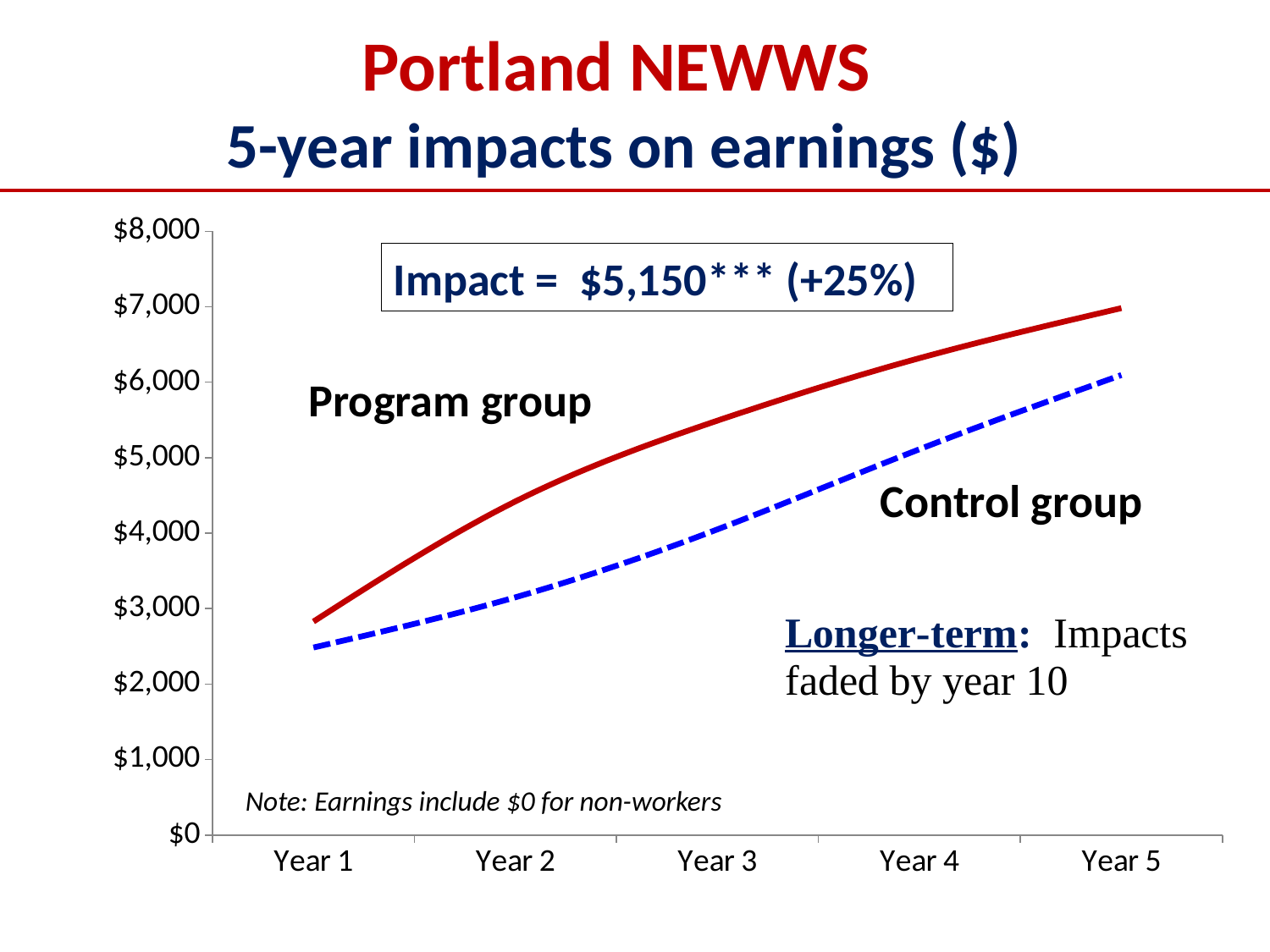
What impact on earnings is stated in the box on the chart? $5,150*** (+25%) Is the Program group's value in Year 1 greater or less than $3,000? less Is the Program group's value in Year 4 greater or less than $6,000? greater Which group is drawn with a dashed blue line? Control group Do the Program group's earnings rise or fall from Year 1 to Year 5? rise How many groups (series) are plotted on the chart? 2 Do the Control group's earnings rise or fall from Year 1 to Year 5? rise Is the Program group's value in Year 3 greater or less than $5,000? greater Which group has higher earnings in Year 5, the Program group or the Control group? Program group How many years are shown along the x axis? 5 What kind of chart is shown on the slide? line chart